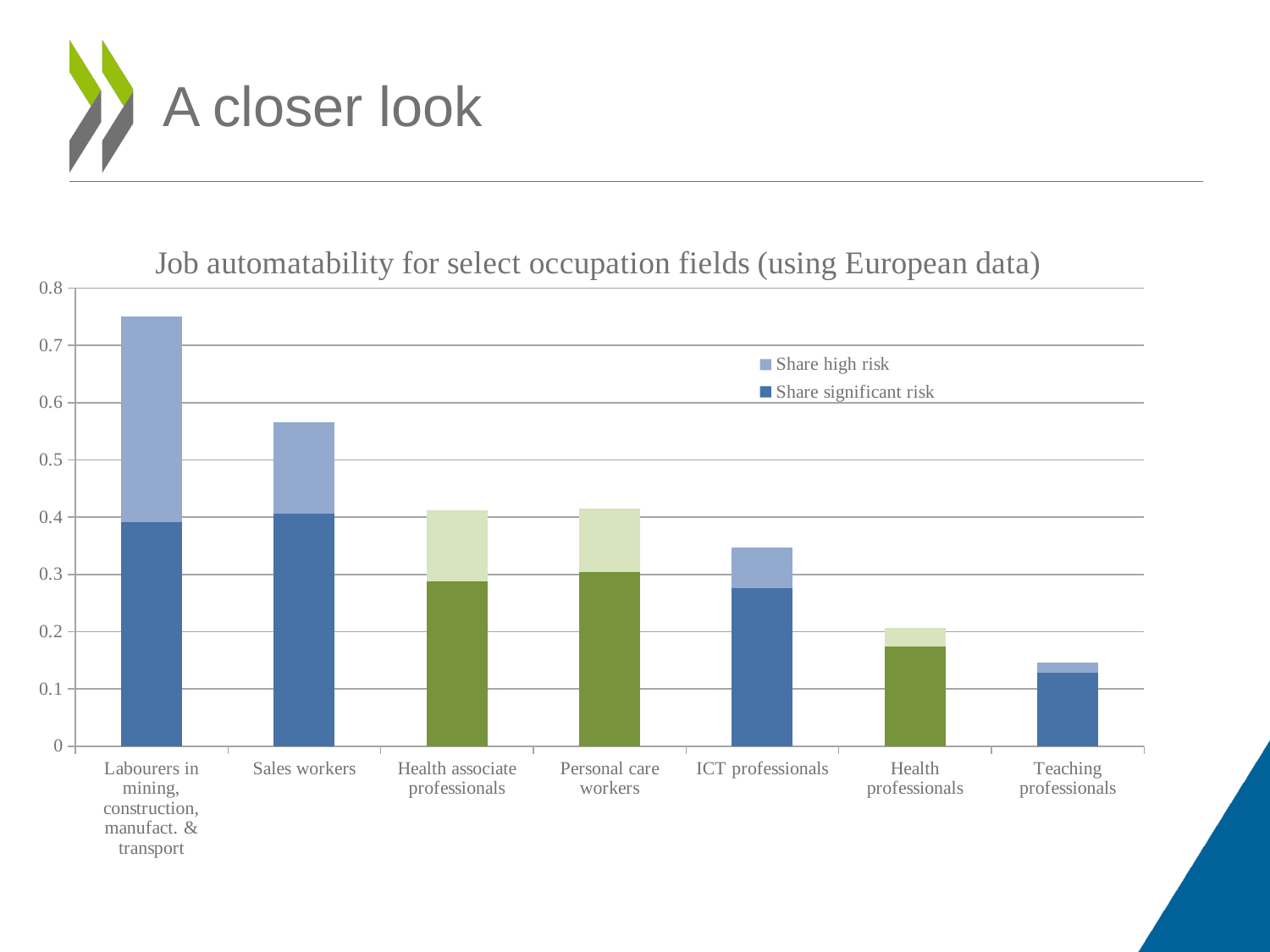
Is the total bar for Labourers in mining, construction, manufact. & transport greater or less than 0.7? greater Is the total bar for Teaching professionals greater or less than 0.2? less Is the total bar for Sales workers greater or less than 0.5? greater Which occupation field has the shortest total bar? Teaching professionals How many series does the legend list? 2 What type of chart is shown on the slide? Stacked bar chart Do the total bar heights generally rise or fall from left to right across the x axis? fall Which occupation field has the tallest total bar? Labourers in mining, construction, manufact. & transport How many occupation fields are shown on the x axis? 7 What is the title of the chart? Job automatability for select occupation fields (using European data) Which has the larger total bar, Health professionals or Teaching professionals? Health professionals